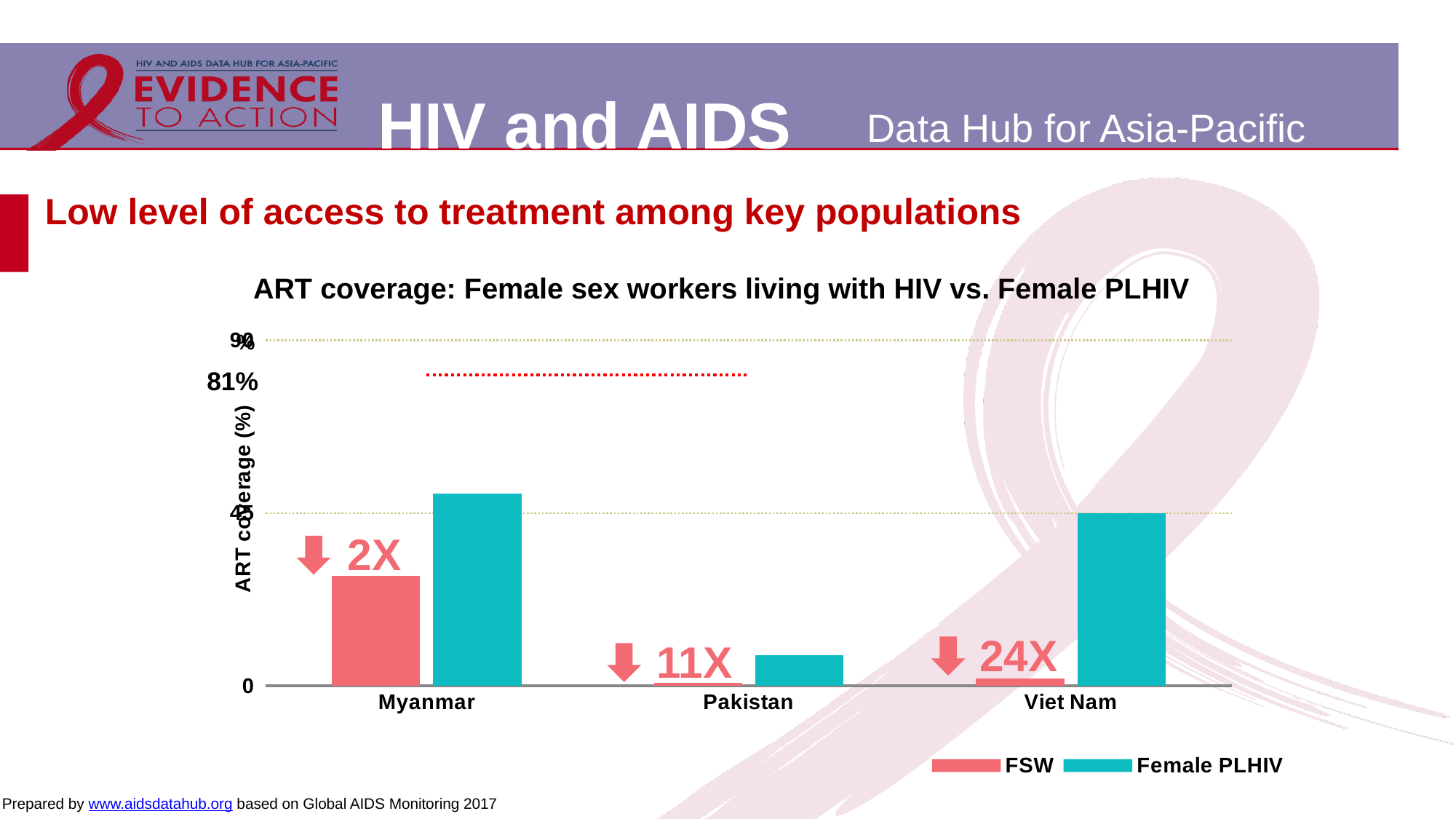
In Viet Nam, which is larger: ART coverage for FSW or for Female PLHIV? Female PLHIV Is the ART coverage for FSW in Myanmar greater or less than 45? less Which country has the lowest ART coverage for FSW? Pakistan What is the title of the chart? ART coverage: Female sex workers living with HIV vs. Female PLHIV How many series does the chart legend list? 2 Is the ART coverage for Female PLHIV in Pakistan greater or less than 45? less How many countries are shown on the x axis of the chart? 3 Which country has the lowest ART coverage for Female PLHIV? Pakistan In Myanmar, which is larger: ART coverage for FSW or for Female PLHIV? Female PLHIV What type of chart is shown on the slide? bar chart Which country has the highest ART coverage for FSW? Myanmar What multiplier annotation is shown next to the Viet Nam bars? 24X